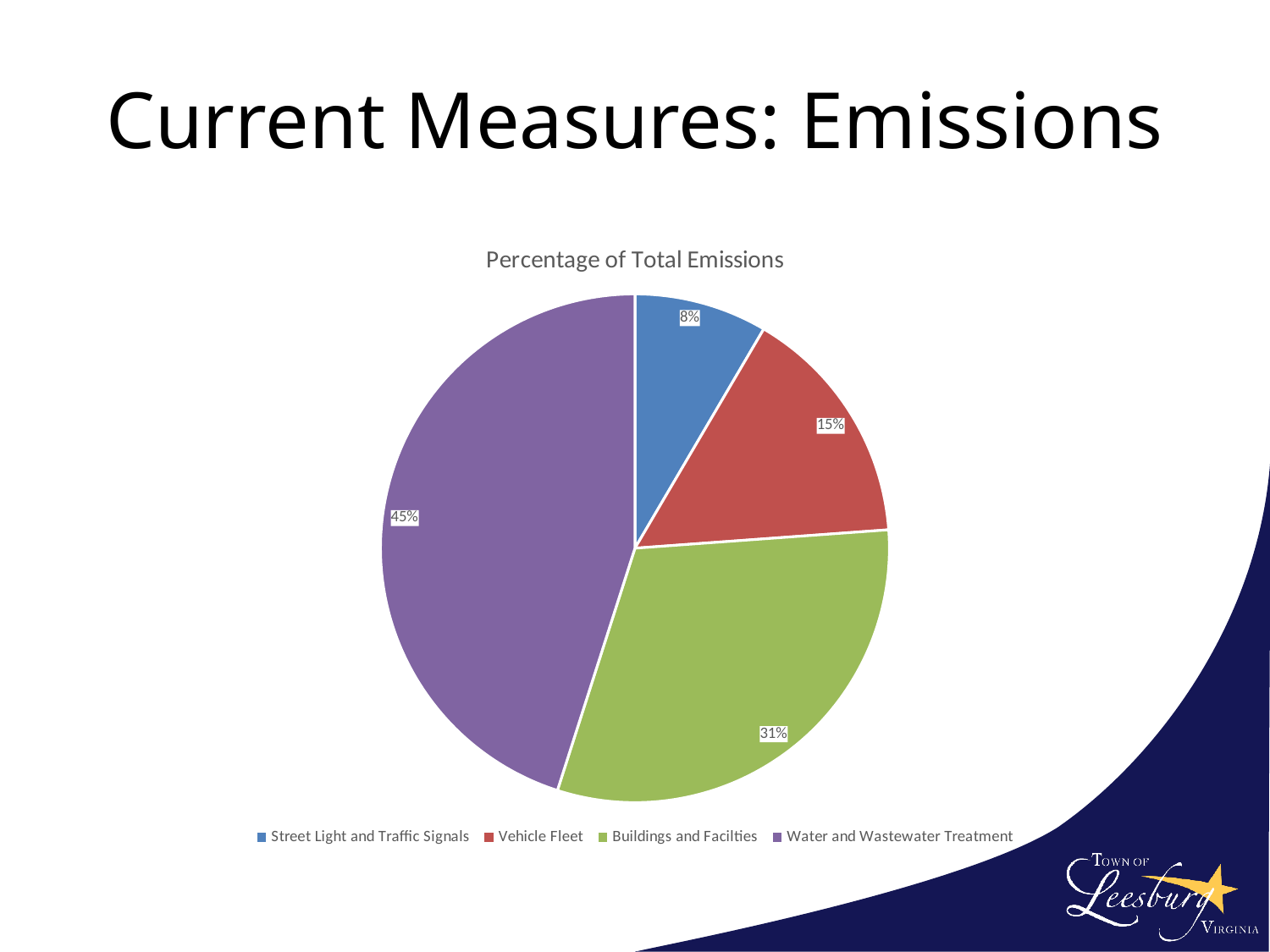
How many categories are shown in the pie chart? 4 What percentage of total emissions comes from Water and Wastewater Treatment? 45% Which category accounts for the largest share of total emissions? Water and Wastewater Treatment What is the difference in percentage points between Water and Wastewater Treatment and Buildings and Facilties? 14 What is the title of the chart? Percentage of Total Emissions What percentage of total emissions comes from Buildings and Facilties? 31% Which is larger, the share for Vehicle Fleet or the share for Street Light and Traffic Signals? Vehicle Fleet What percentage of total emissions comes from Vehicle Fleet? 15% What type of chart is shown on the slide? Pie chart Which category accounts for the smallest share of total emissions? Street Light and Traffic Signals What colour is the slice for Buildings and Facilties? Green What percentage of total emissions comes from Street Light and Traffic Signals? 8%